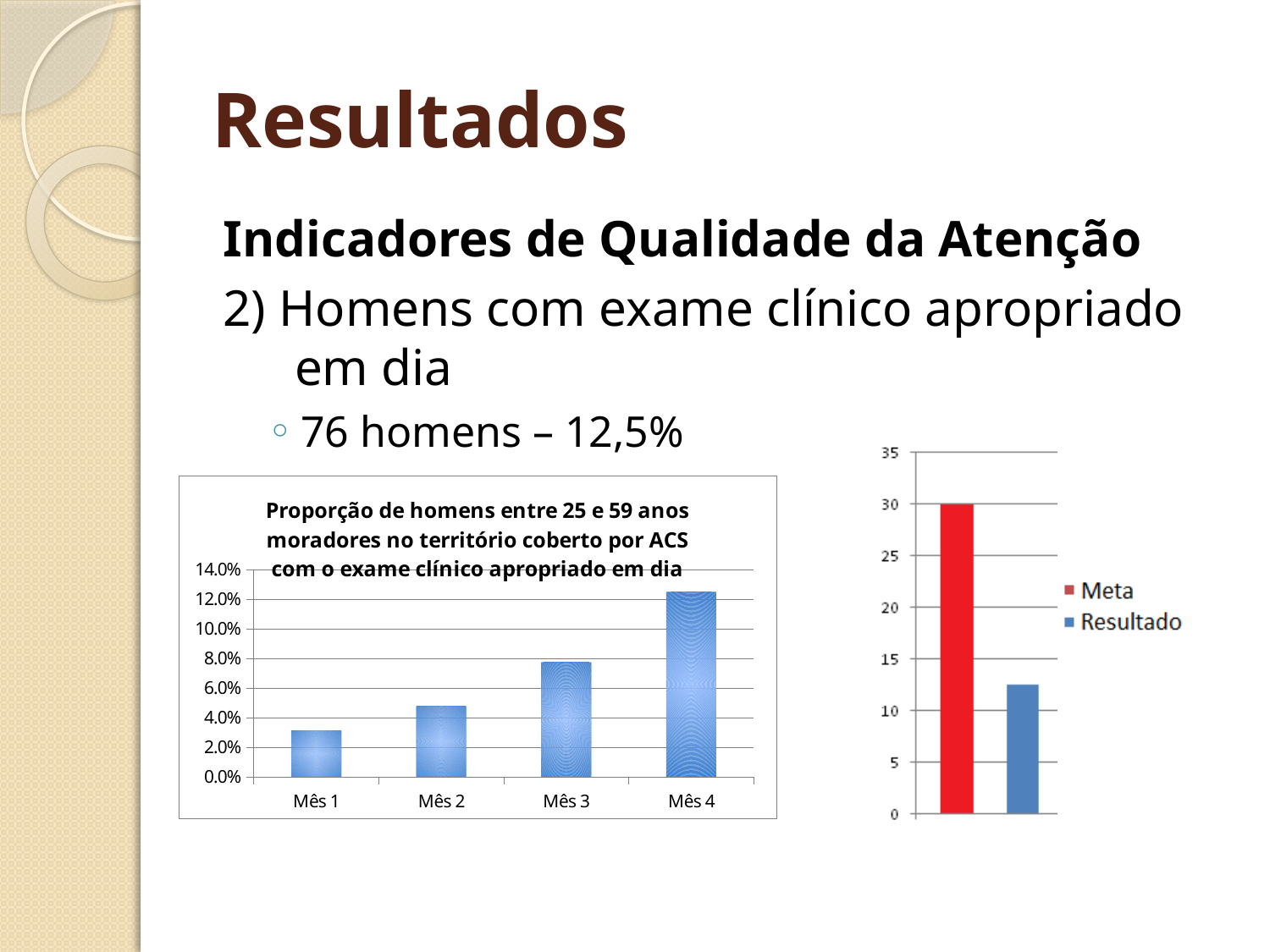
What kind of chart is the left chart titled 'Proporção de homens entre 25 e 59 anos moradores no território coberto por ACS com o exame clínico apropriado em dia'? bar chart How many series does the legend of the right chart list? 2 In the right chart, what is the value of Meta? 30 In the right chart, is the value for Resultado greater or less than 15? less In the left chart, which month has the lowest value? Mês 1 In the left chart, is the value for Mês 2 greater or less than 6.0%? less In the left chart, which is larger, the value for Mês 3 or the value for Mês 2? Mês 3 In the left chart, is the value for Mês 4 greater or less than 12.0%? greater In the left chart, do the values rise or fall from Mês 1 to Mês 4? rise How many categories are shown on the x axis of the left chart? 4 In the left chart, which month has the highest value? Mês 4 In the right chart, which series is shown in red? Meta